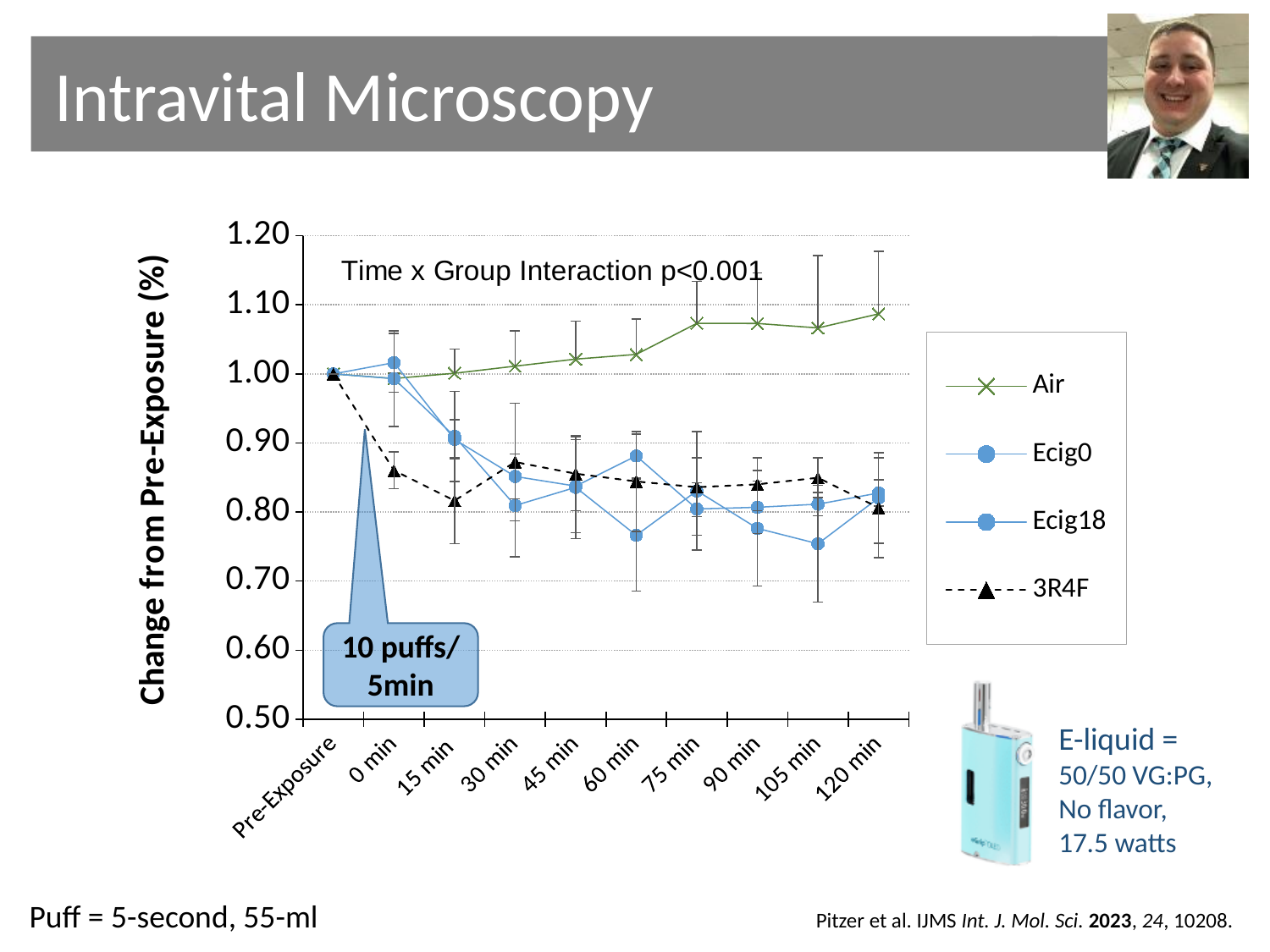
Is the value for Air at 120 min greater or less than 1.00? greater What kind of chart is shown on the slide? line chart Which series are listed in the legend? Air, Ecig0, Ecig18, 3R4F How many time points are shown along the x axis? 10 At 75 min, which is larger, the value for Air or the value for 3R4F? Air Is the value for 3R4F at 15 min greater or less than 0.90? less Does the Air series rise or fall from Pre-Exposure to 120 min? rise How many series does the legend list? 4 What statistical result is annotated at the top of the chart? Time x Group Interaction p<0.001 Which series has the highest value at 120 min? Air